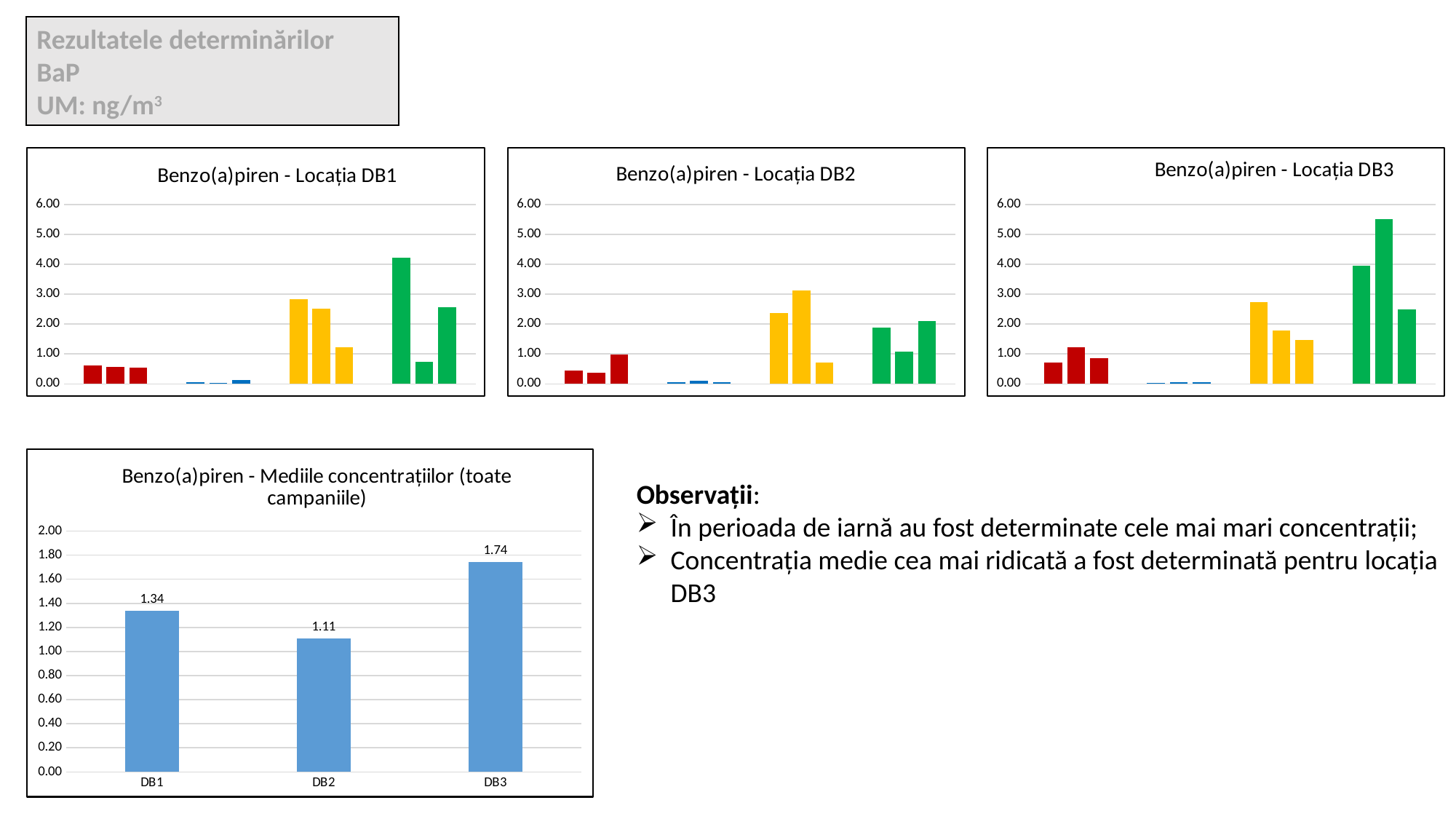
In the chart titled 'Benzo(a)piren - Mediile concentrațiilor (toate campaniile)', what is the difference between the values for DB1 and DB2? 0.23 In the chart titled 'Benzo(a)piren - Mediile concentrațiilor (toate campaniile)', what is the value for DB2? 1.11 In the chart titled 'Benzo(a)piren - Mediile concentrațiilor (toate campaniile)', which location has the highest value? DB3 In the chart titled 'Benzo(a)piren - Mediile concentrațiilor (toate campaniile)', which location has the lowest value? DB2 In the chart titled 'Benzo(a)piren - Mediile concentrațiilor (toate campaniile)', is the value for DB3 greater or less than 1.60? greater In the chart titled 'Benzo(a)piren - Mediile concentrațiilor (toate campaniile)', what is the difference between the values for DB3 and DB1? 0.40 In the chart titled 'Benzo(a)piren - Mediile concentrațiilor (toate campaniile)', which is larger, the value for DB1 or DB2? DB1 In the chart titled 'Benzo(a)piren - Mediile concentrațiilor (toate campaniile)', what is the value for DB3? 1.74 How many locations are shown in the chart titled 'Benzo(a)piren - Mediile concentrațiilor (toate campaniile)'? 3 What kind of chart is 'Benzo(a)piren - Locația DB1'? bar chart In the chart titled 'Benzo(a)piren - Locația DB3', is the tallest bar greater or less than 5.00? greater In the chart titled 'Benzo(a)piren - Mediile concentrațiilor (toate campaniile)', what is the value for DB1? 1.34